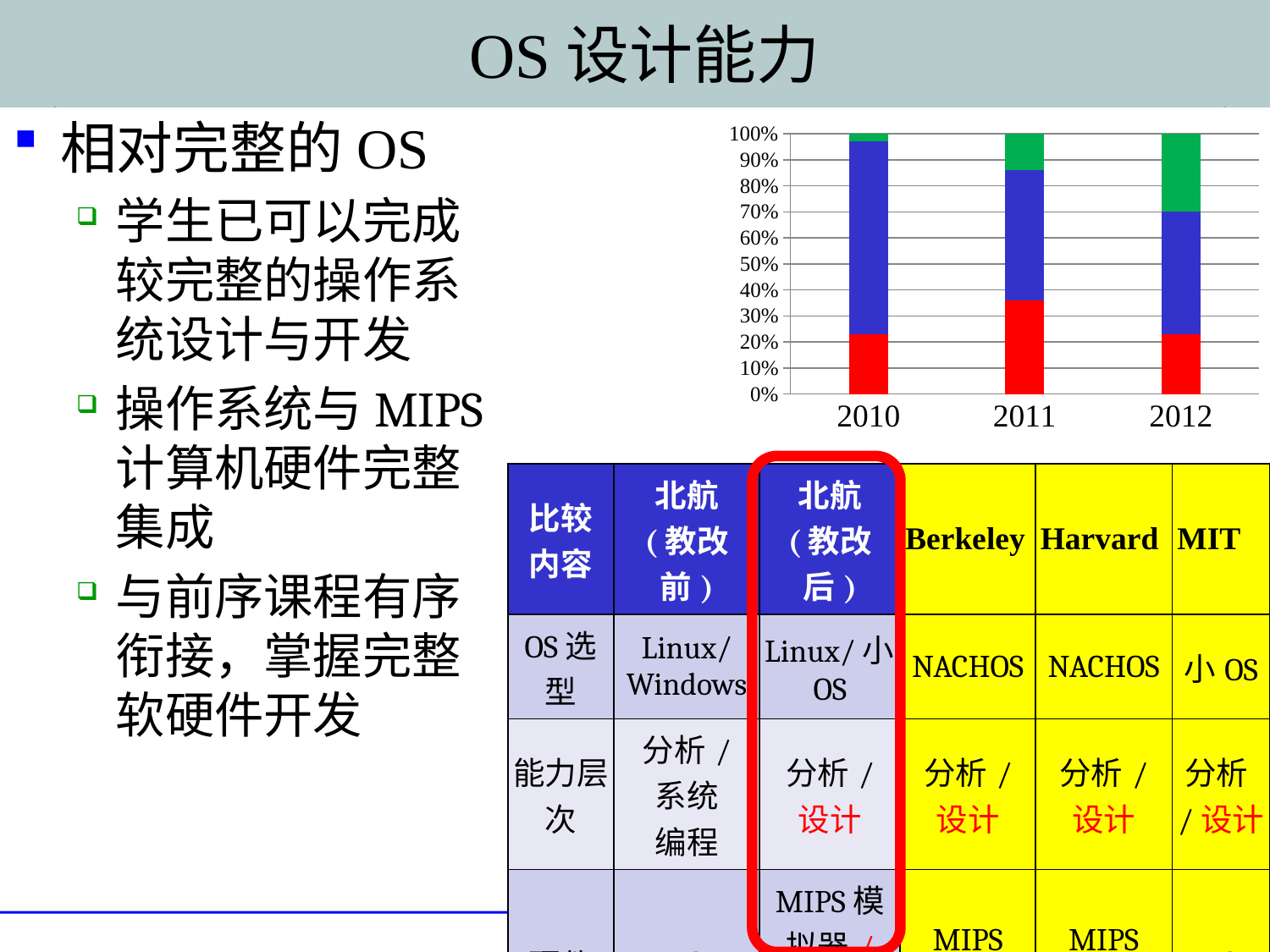
Is the red segment for 2010 greater or less than 30%? less In which year is the red segment the largest? 2011 Which years are shown on the x axis of the chart? 2010, 2011, 2012 What kind of chart is shown at the top right of the slide? stacked bar chart Is the green segment for 2010 greater or less than 10%? less Does the green segment at the top of the bars grow or shrink from 2010 to 2012? grow Is the red segment for 2011 greater or less than 30%? greater In which year is the green segment the largest? 2012 How many years are shown on the x axis of the chart? 3 How many coloured segments does each bar in the chart have? 3 In which year is the green segment the smallest? 2010